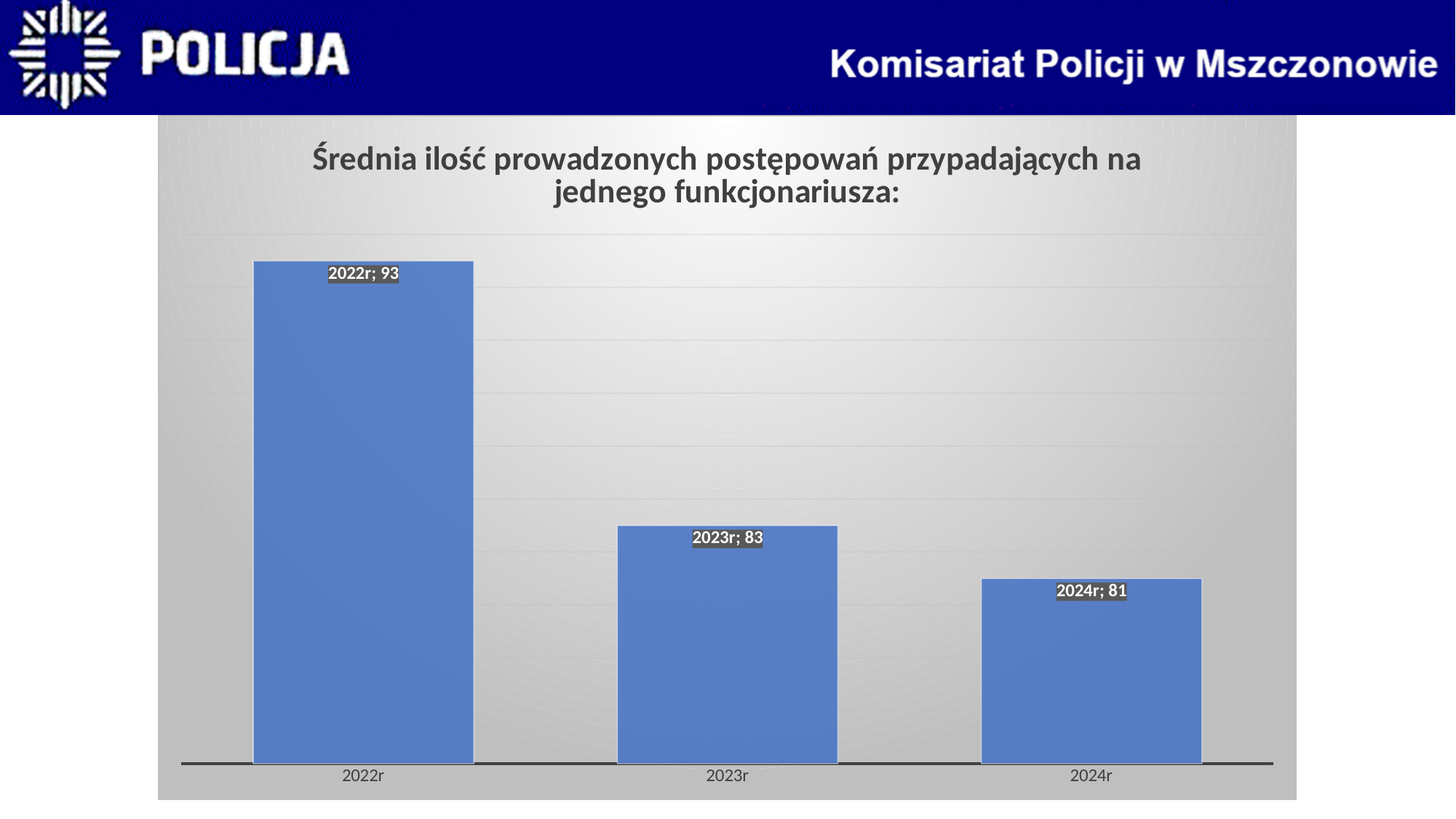
Which is larger, the value for 2022r or the value for 2024r? 2022r What is the title of the chart? Średnia ilość prowadzonych postępowań przypadających na jednego funkcjonariusza: How many years are shown on the chart? 3 What is the value for 2022r? 93 What is the difference between the values for 2023r and 2024r? 2 Do the values rise or fall from 2022r to 2024r? fall What kind of chart is shown on the slide? bar chart Which year has the highest value? 2022r What is the value for 2024r? 81 Which year has the lowest value? 2024r What is the difference between the values for 2022r and 2023r? 10 What is the value for 2023r? 83